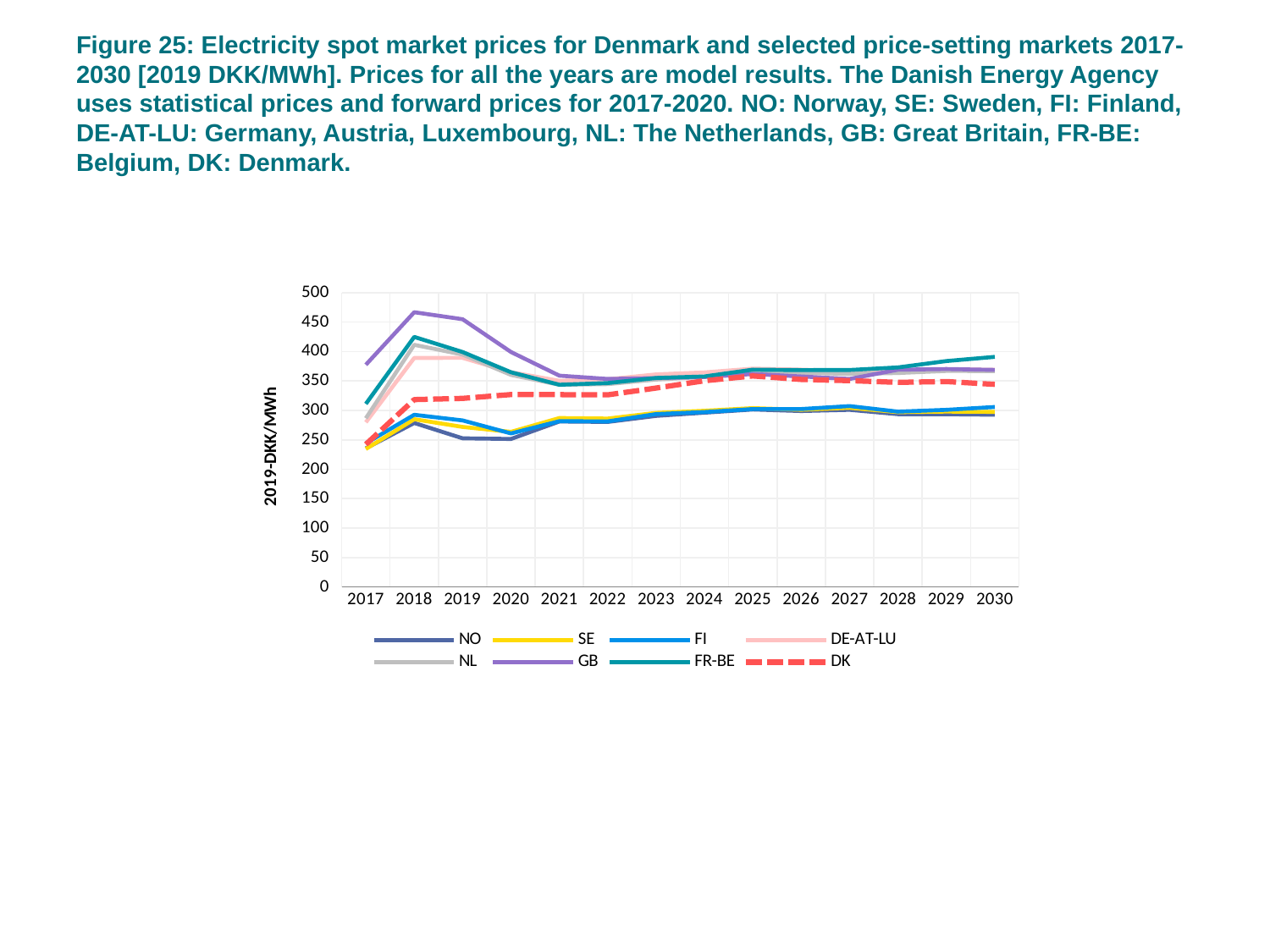
Is the value for DK in 2017 greater or less than 300? less In 2025, which is larger: the value for DK or the value for NO? DK How many years are shown along the x axis? 14 Which series is drawn with a dashed line? DK What kind of chart is shown on the slide? line chart Is the value for GB in 2018 greater or less than 400? greater Which series has the highest value in 2018? GB Does the GB series rise or fall from 2018 to 2021? fall Which series has the highest value in 2030? FR-BE How many series does the legend list? 8 Is the value for NO in 2020 greater or less than 300? less